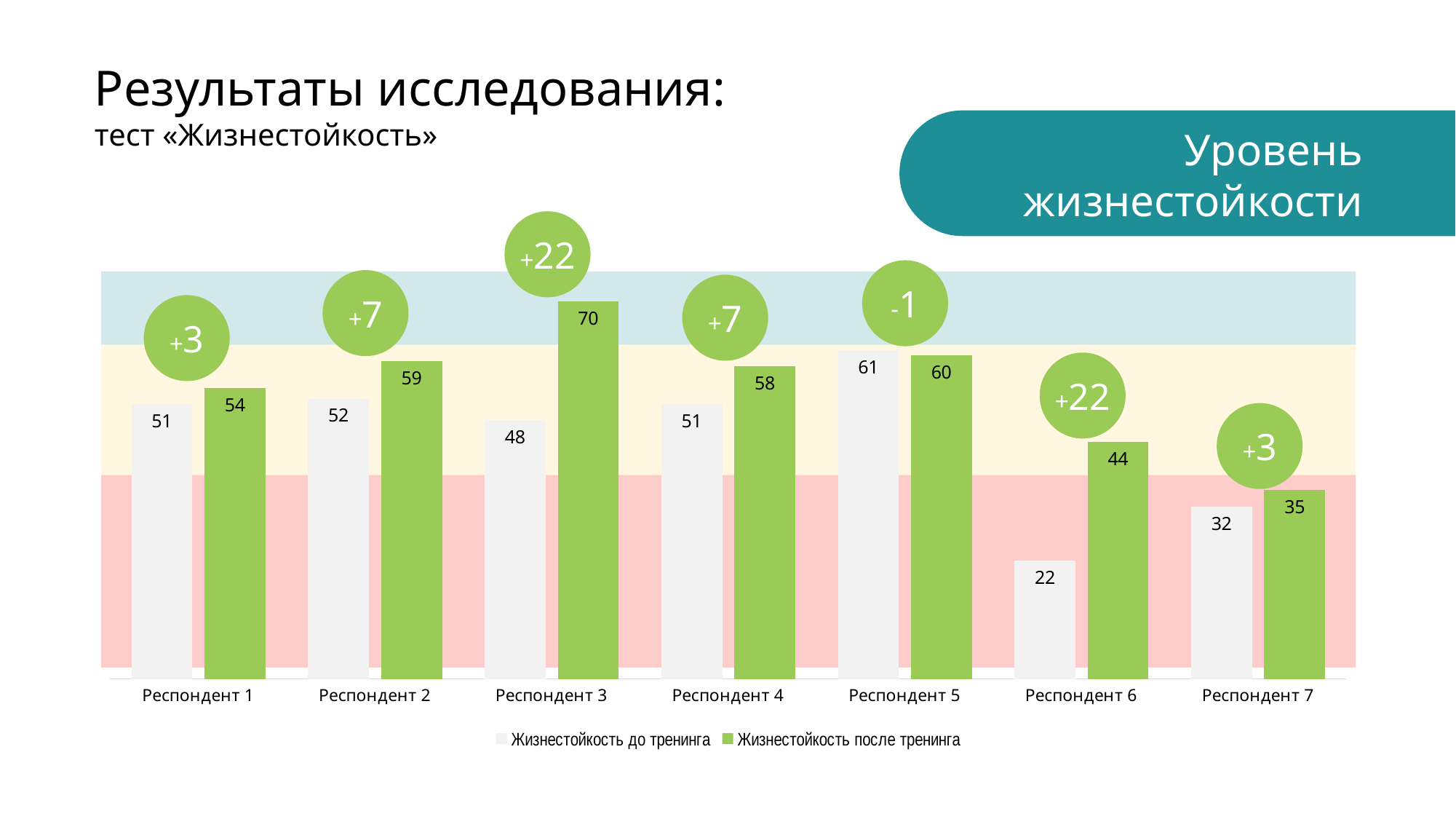
Which respondent has the lowest value for "Жизнестойкость до тренинга"? Респондент 6 How many respondents are shown on the x axis of the chart? 7 Which is larger for Респондент 5: "Жизнестойкость до тренинга" or "Жизнестойкость после тренинга"? Жизнестойкость до тренинга What is the value of "Жизнестойкость до тренинга" for Респондент 5? 61 What kind of chart is shown on the slide? Bar chart What is the difference between "Жизнестойкость после тренинга" and "Жизнестойкость до тренинга" for Респондент 3? 22 Which series is shown in green in the chart legend? Жизнестойкость после тренинга What is the value of "Жизнестойкость до тренинга" for Респондент 3? 48 Which respondent has the highest value for "Жизнестойкость после тренинга"? Респондент 3 What is the value of "Жизнестойкость после тренинга" for Респондент 6? 44 How many series does the chart legend list? 2 What is the difference between "Жизнестойкость после тренинга" and "Жизнестойкость до тренинга" for Респондент 7? 3